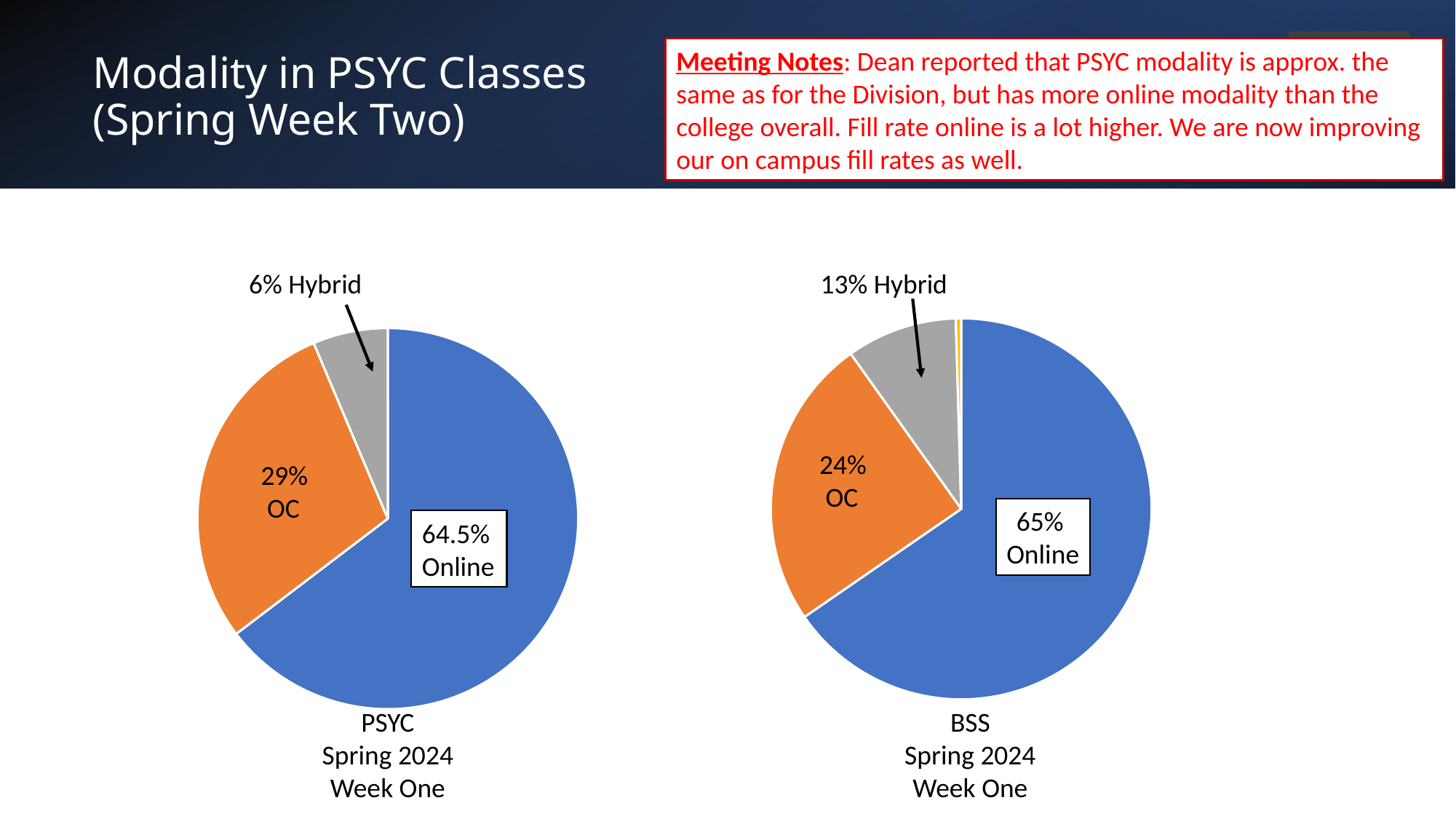
What kind of chart is used to show modality for PSYC Spring 2024 Week One? Pie chart In the PSYC Spring 2024 Week One chart, what share of classes is Online? 64.5% What is the difference between the OC share in the PSYC chart and the OC share in the BSS chart? 5% In the PSYC Spring 2024 Week One chart, which modality has the smallest labelled share? Hybrid What is the difference between the Hybrid share in the BSS chart and the Hybrid share in the PSYC chart? 7% In the PSYC Spring 2024 Week One chart, what share of classes is OC? 29% In the PSYC Spring 2024 Week One chart, which modality has the largest share? Online How many labelled slices does the PSYC Spring 2024 Week One pie chart have? 3 Which chart has the larger Hybrid share, PSYC Spring 2024 Week One or BSS Spring 2024 Week One? BSS Spring 2024 Week One In the BSS Spring 2024 Week One chart, what share of classes is Hybrid? 13% In the BSS Spring 2024 Week One chart, which modality has the largest share? Online In the BSS Spring 2024 Week One chart, what share of classes is OC? 24%